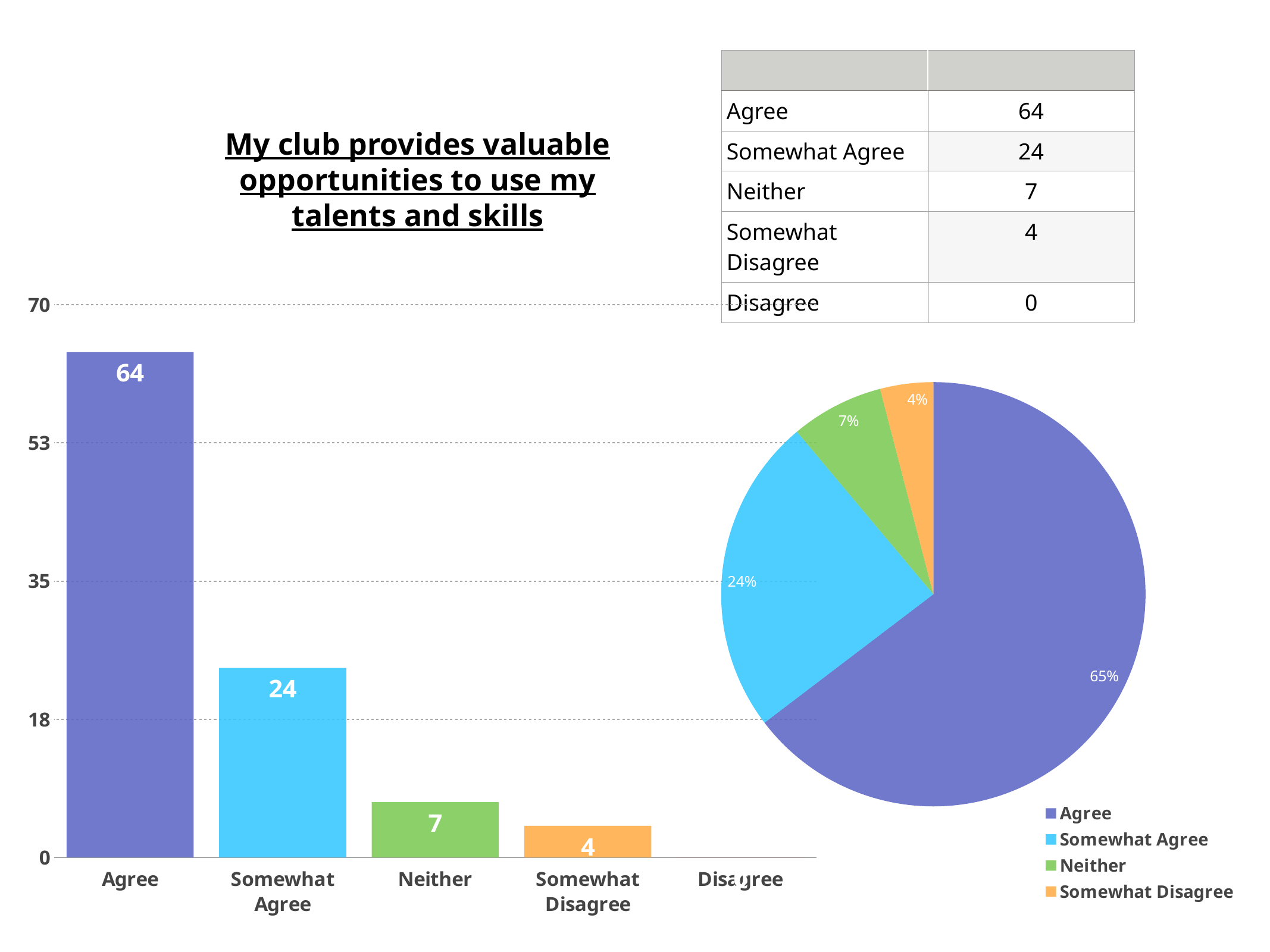
In the bar chart, what is the value for Somewhat Disagree? 4 In the bar chart, what is the difference between the values for Agree and Somewhat Agree? 40 In the bar chart, which category has the highest value? Agree How many entries does the legend of the pie chart list? 4 In the bar chart, what is the value for Neither? 7 What kind of chart is on the left side of the slide? bar chart In the bar chart, what is the value for Somewhat Agree? 24 In the pie chart, what share does the Somewhat Agree slice have? 24% In the bar chart, is the value for Agree greater or less than 53? greater In the bar chart, what is the value for Agree? 64 In the bar chart, which is larger, the value for Neither or the value for Somewhat Disagree? Neither In the pie chart, what share does the Agree slice have? 65%